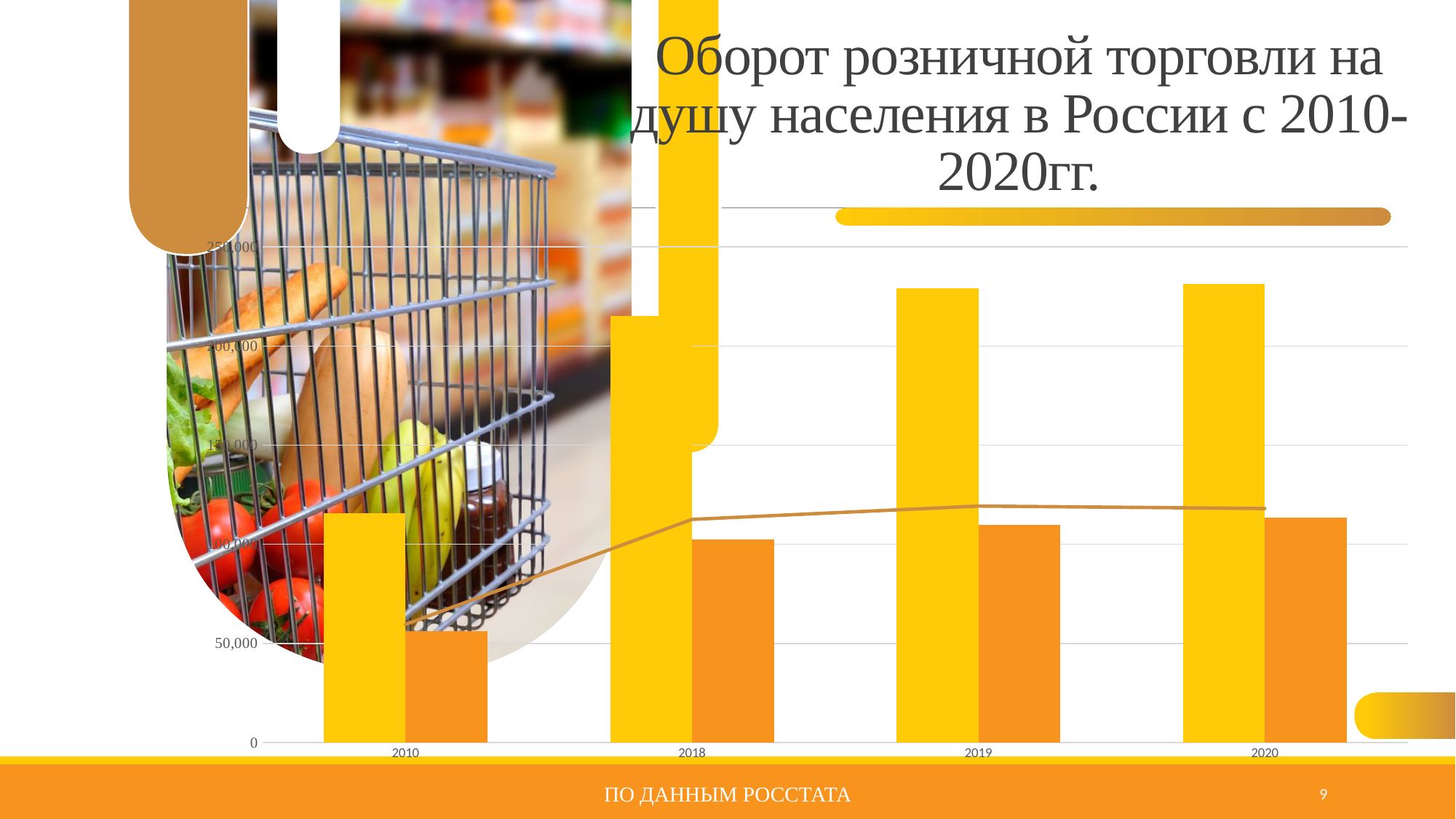
Which year has the lowest yellow bar in the chart? 2010 Is the orange bar for 2020 greater or less than 150,000? less What kind of chart is shown on the slide? combination bar and line chart Is the yellow bar for 2010 greater or less than 100,000? greater Which year has the lowest orange bar in the chart? 2010 Which is larger, the yellow bar for 2010 or the yellow bar for 2018? 2018 How many years (categories) are shown on the x axis of the chart? 4 Is the orange bar for 2019 greater or less than 100,000? greater Do the orange bars rise or fall from 2010 to 2020? rise What is the title of the chart on the slide? Оборот розничной торговли на душу населения в России с 2010-2020гг.